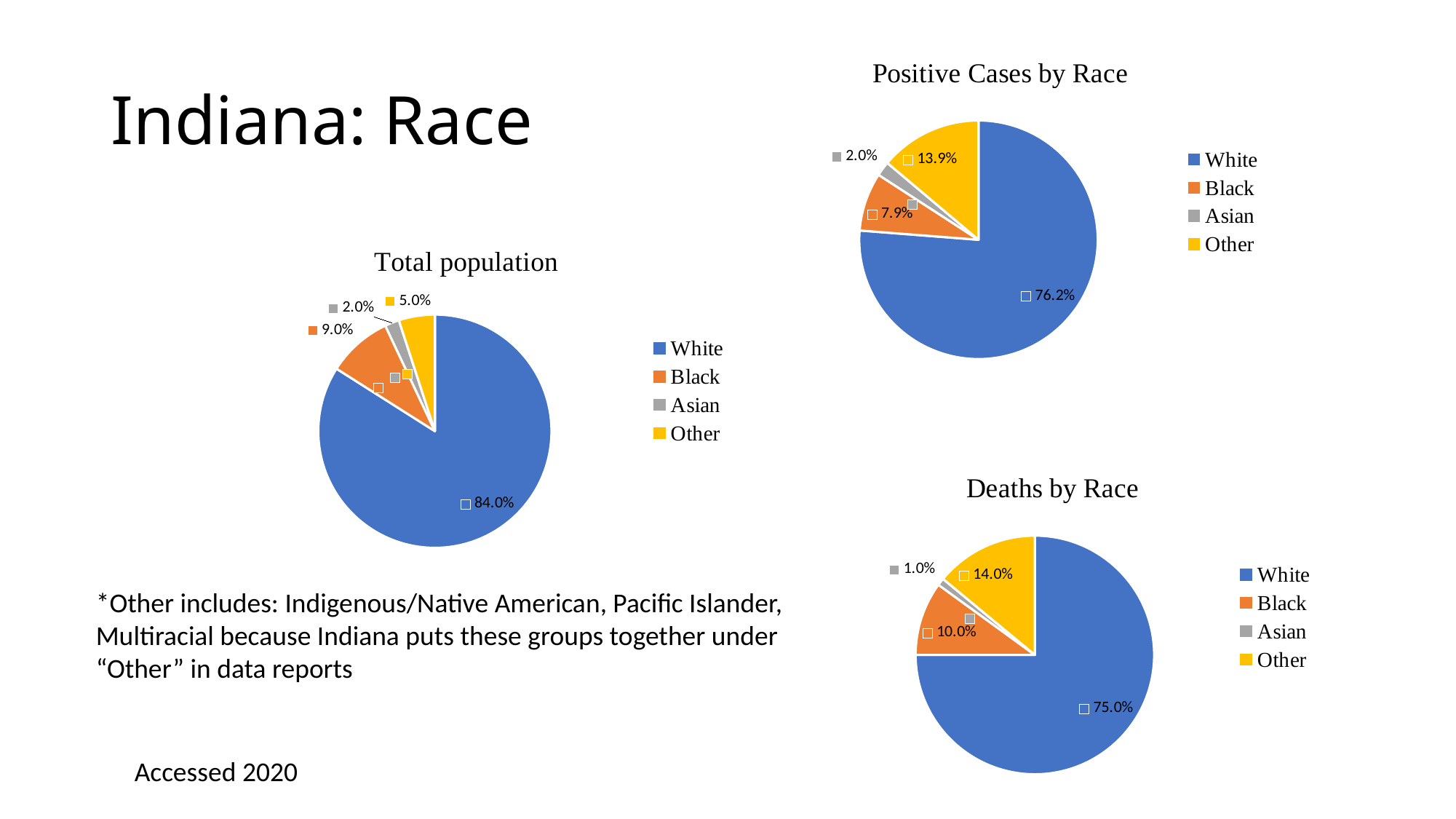
In the "Positive Cases by Race" chart, what is the value for Other? 13.9% In the "Positive Cases by Race" chart, what is the value for Black? 7.9% In the "Total population" chart, what is the value for Black? 9.0% In the "Deaths by Race" chart, what colour is the Other slice? Yellow In the "Total population" chart, what share of the pie is White? 84.0% In the "Deaths by Race" chart, what is the difference between the Other and Black values? 4.0% In the "Deaths by Race" chart, which category has the largest slice? White Is the Black share larger in the "Total population" chart or in the "Deaths by Race" chart? Deaths by Race What kind of chart is "Positive Cases by Race"? Pie chart In the "Positive Cases by Race" chart, which category has the smallest slice? Asian In the "Deaths by Race" chart, what is the value for Asian? 1.0% How many categories does the "Total population" chart show? 4